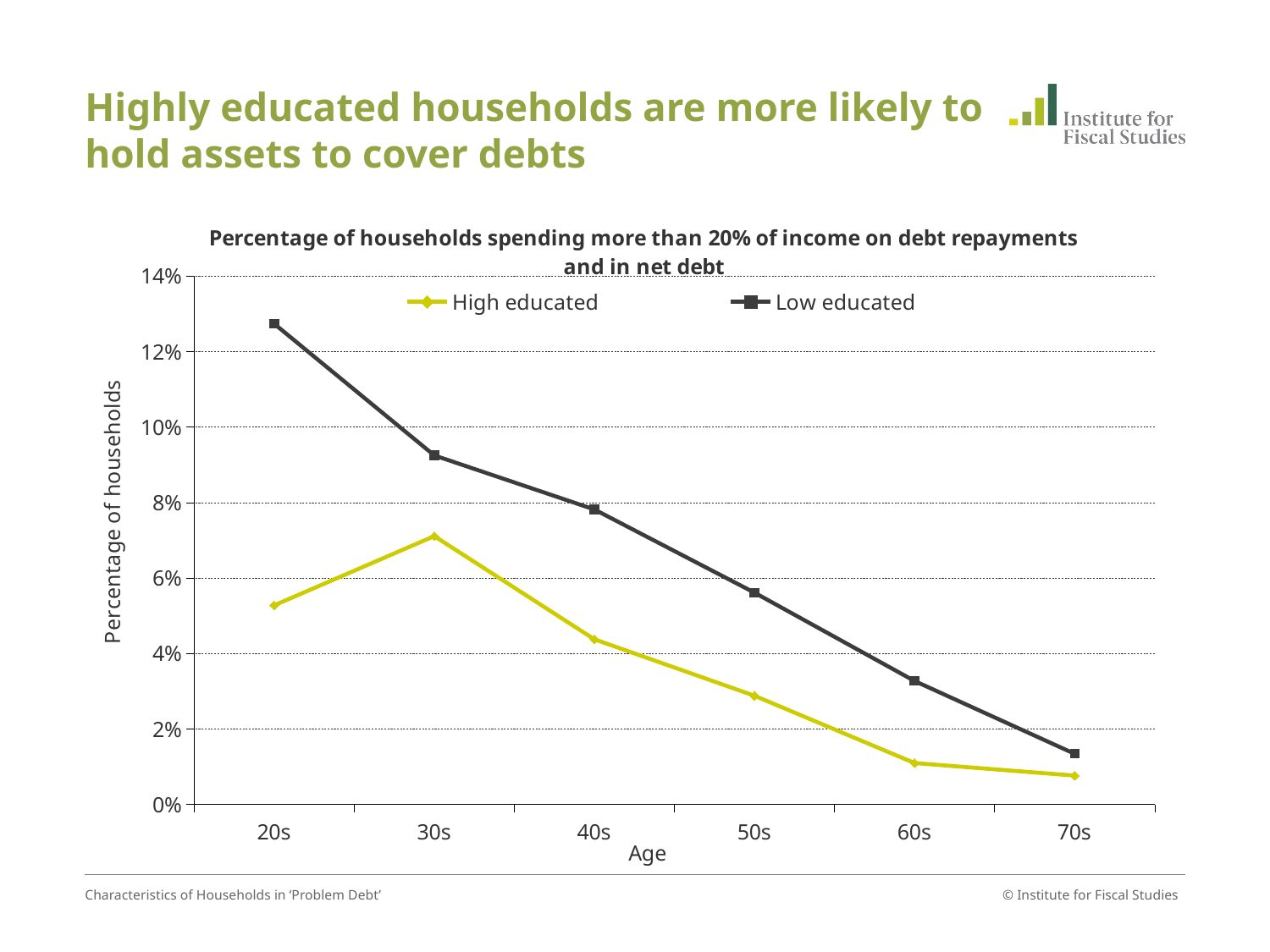
Is the value for High educated at age 60s greater or less than 2%? less For the High educated series, which age group has the highest value? 30s How many series does the legend list? 2 How many age groups are plotted along the x axis? 6 For the High educated series, which age group has the lowest value? 70s Is the value for Low educated at age 20s greater or less than 12%? greater Does the Low educated line rise or fall as age increases from 20s to 70s? falls For the Low educated series, which age group has the lowest value? 70s At age 40s, which series has the larger value, High educated or Low educated? Low educated For the Low educated series, which age group has the highest value? 20s Is the value for High educated at age 30s greater or less than 6%? greater What kind of chart is shown on the slide? line chart